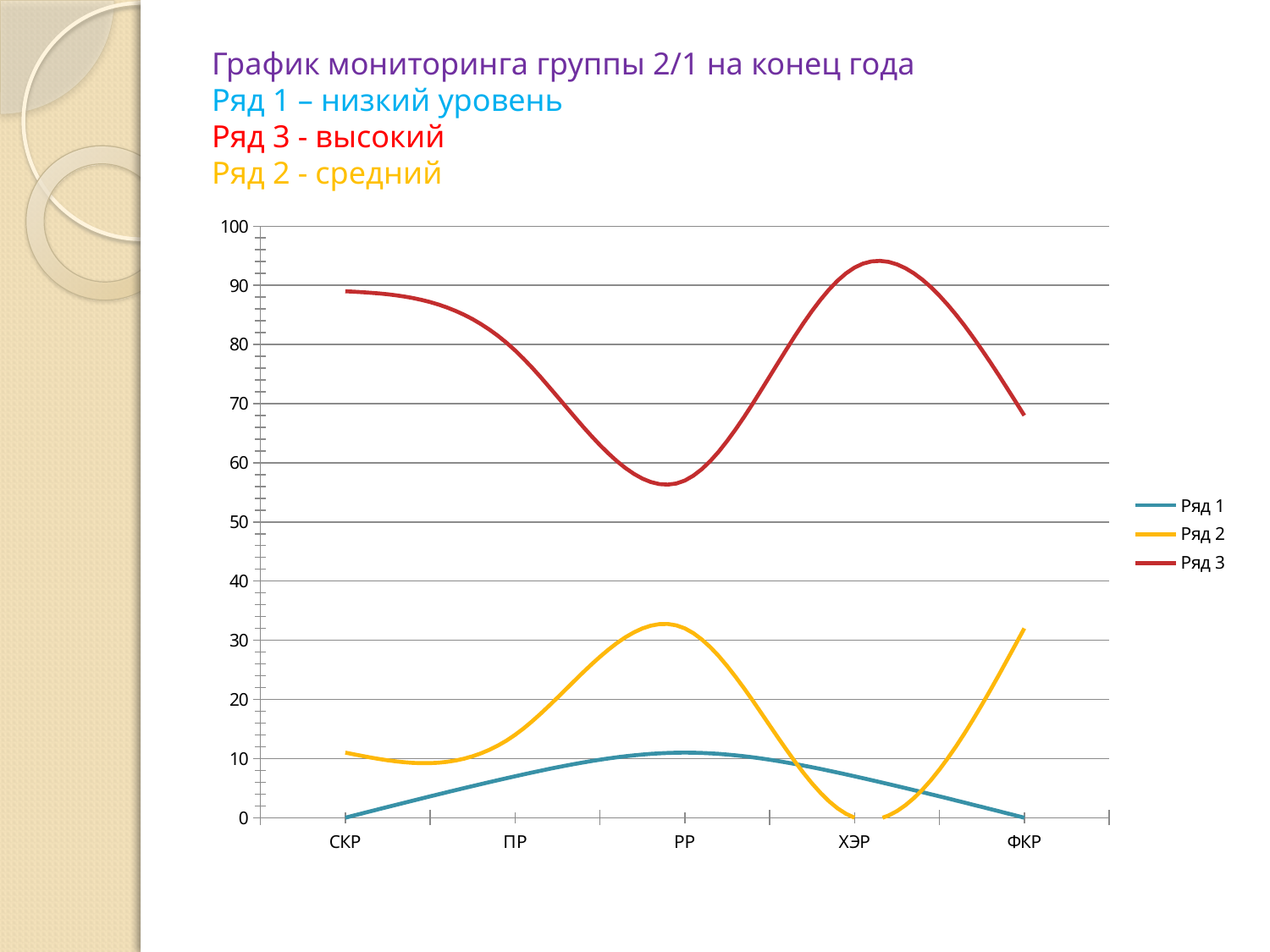
Is the value of Ряд 3 at СКР greater or less than 80? greater Is the value of Ряд 3 at РР greater or less than 60? less What is the value of Ряд 2 at ХЭР? 0 Which series has the larger value at РР, Ряд 2 or Ряд 3? Ряд 3 What kind of chart is shown on the slide? line chart What is the value of Ряд 1 at ФКР? 0 Does Ряд 3 rise or fall from СКР to РР? fall What is the value of Ряд 1 at СКР? 0 How many categories are shown on the x axis? 5 How many series does the legend list? 3 At which category does Ряд 3 reach its highest value? ХЭР At which category does Ряд 3 reach its lowest value? РР